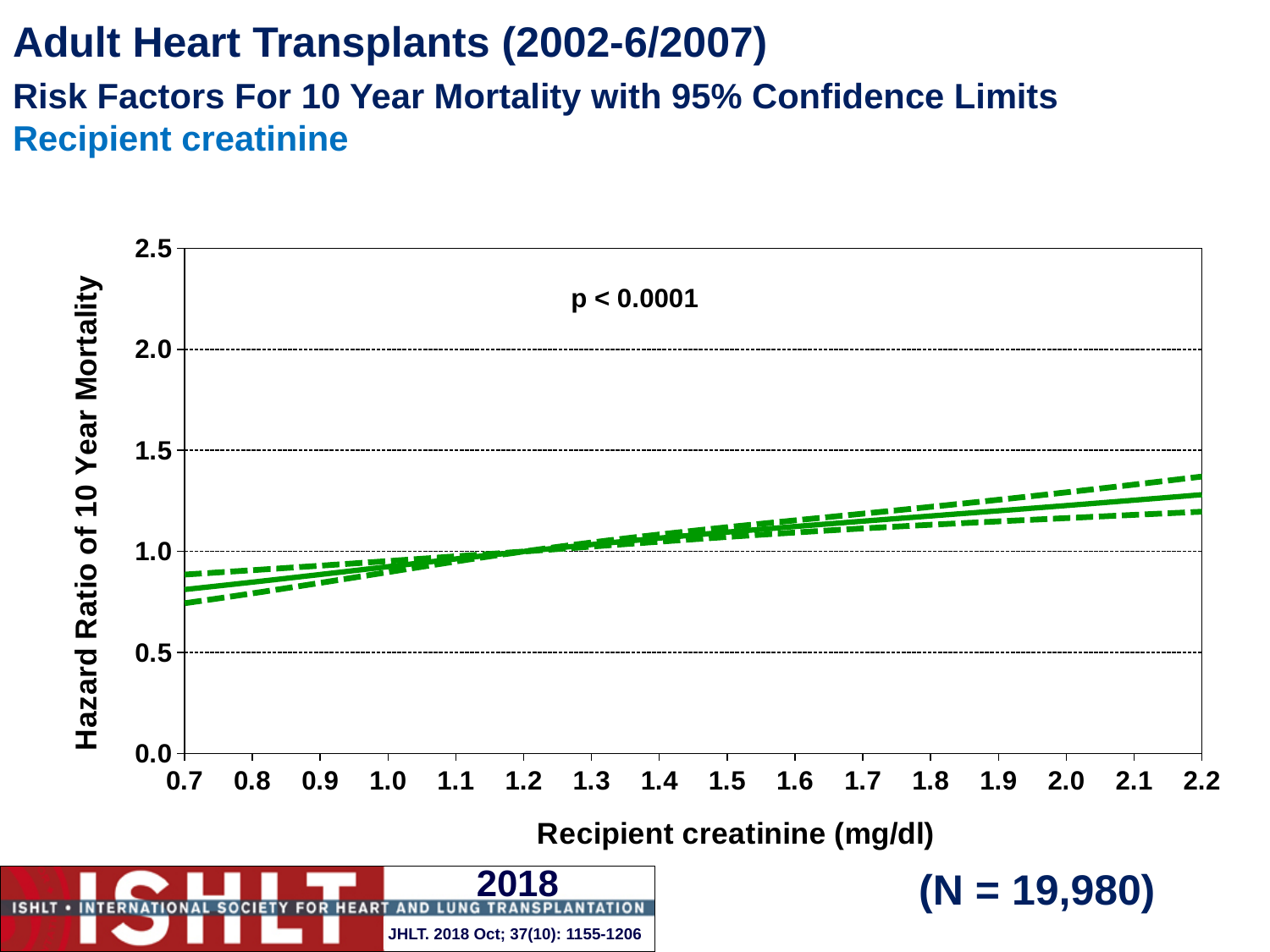
What p-value is printed on the chart? p < 0.0001 Is the hazard ratio at a recipient creatinine of 2.2 mg/dl greater or less than 1.0? greater Is the hazard ratio at a recipient creatinine of 2.2 mg/dl greater or less than 1.5? less Which has the higher hazard ratio: a recipient creatinine of 0.7 mg/dl or 2.2 mg/dl? 2.2 mg/dl Is the hazard ratio at a recipient creatinine of 0.7 mg/dl greater or less than 1.0? less What is the sample size (N) shown on the slide? N = 19,980 What is the highest value shown on the y axis? 2.5 Does the hazard ratio of 10 year mortality rise or fall as recipient creatinine increases from 0.7 to 2.2 mg/dl? rise What kind of chart is shown on the slide? line chart